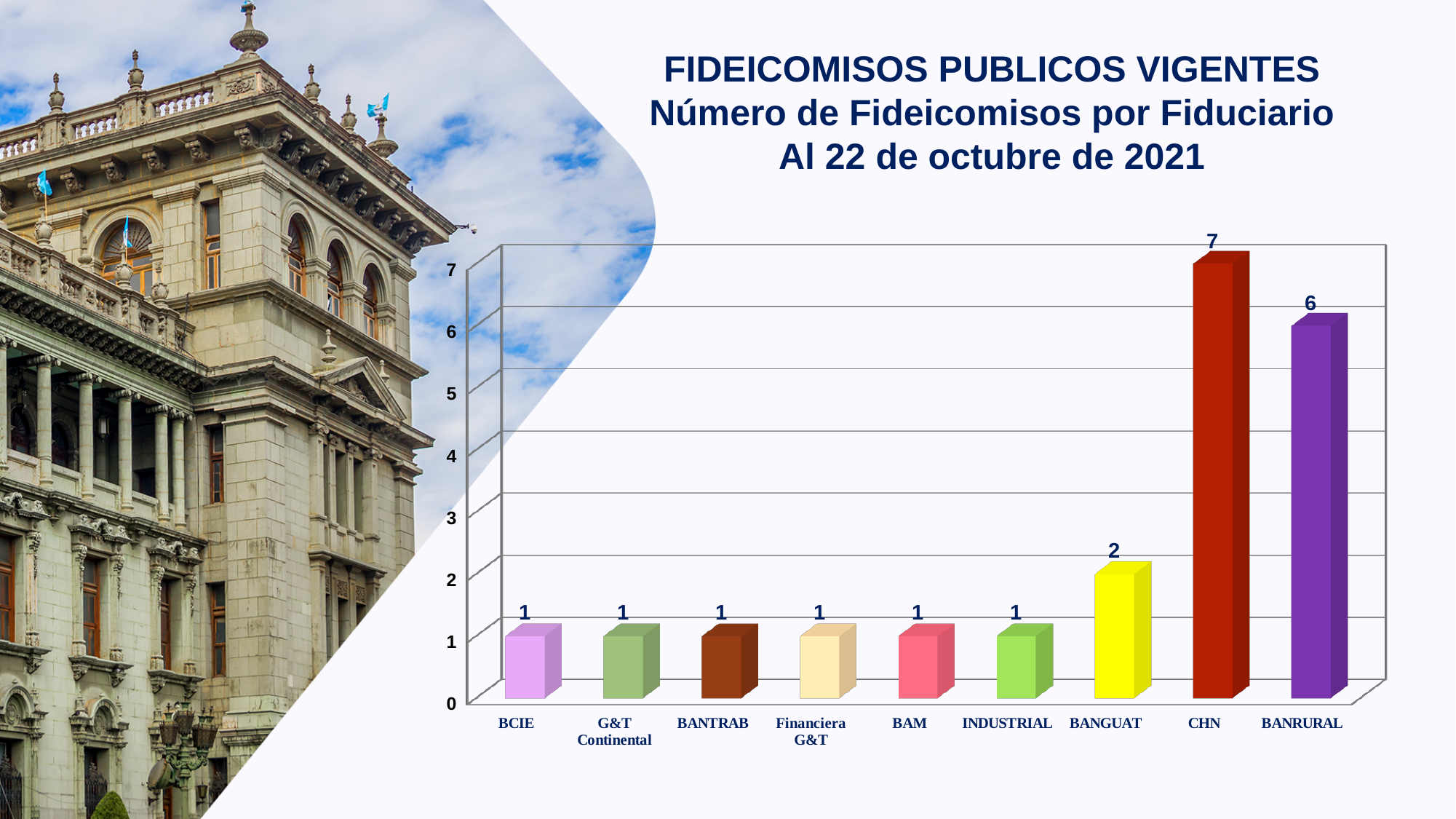
What is the value for BANGUAT? 2 Which fiduciario has the highest number of fideicomisos? CHN What kind of chart is shown on the slide? Bar chart What date does the chart title say the data is as of? 22 de octubre de 2021 How many fiduciarios are shown on the x axis? 9 How many fiduciarios have a value of 1? 6 Which is larger, the value for BANGUAT or the value for INDUSTRIAL? BANGUAT What is the difference between the values for BANRURAL and BANGUAT? 4 What is the difference between the values for CHN and BANRURAL? 1 What is the value for BANRURAL? 6 What is the value for CHN? 7 What is the value for BCIE? 1